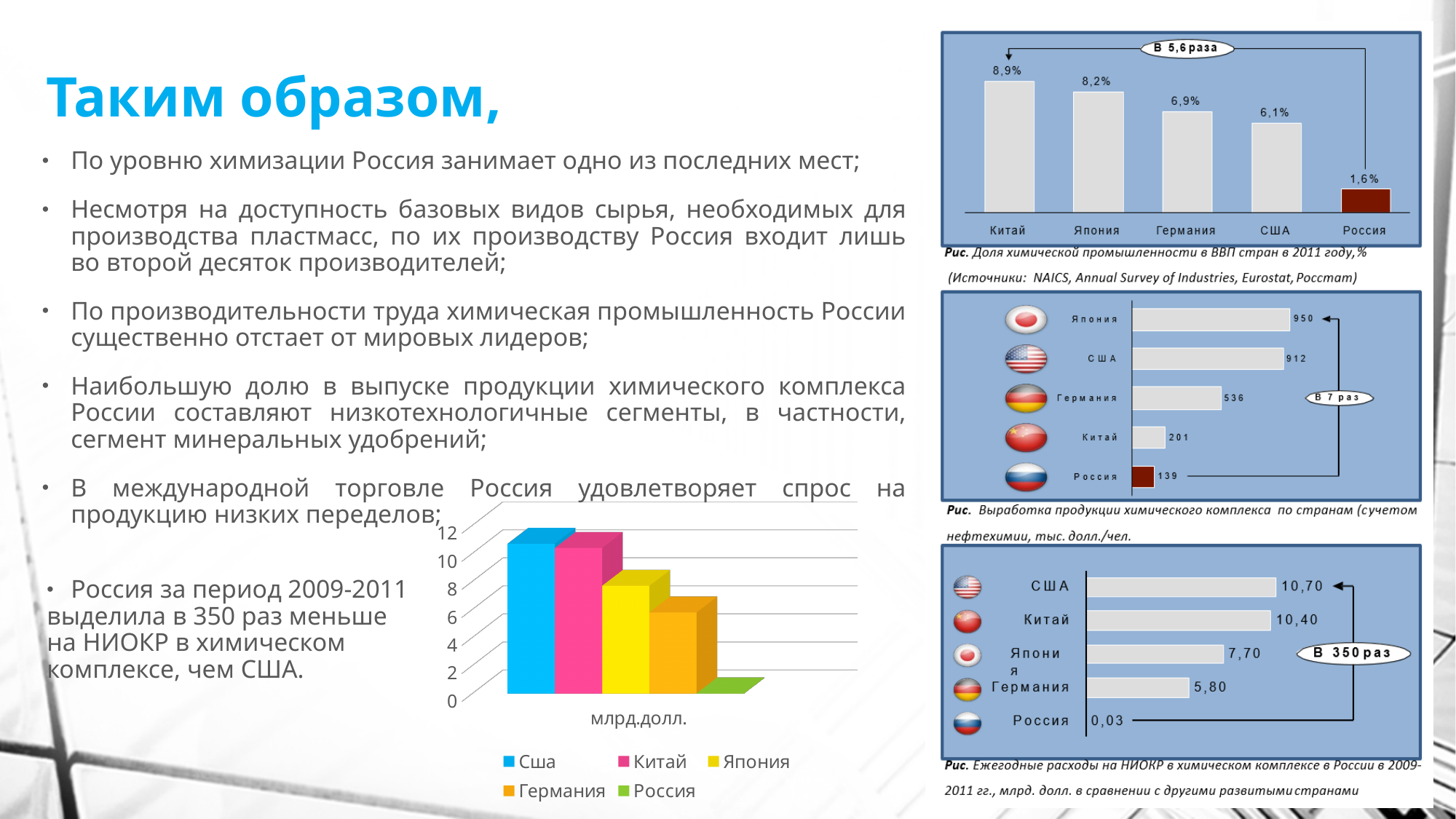
In the middle-right chart (output of chemical products per person), which is larger, Китай or Россия? Китай In the top-right chart (share of chemical industry in GDP, 2011), which country has the lowest value? Россия What kind of chart is the bottom-left chart with the legend США, Китай, Япония, Германия, Россия? bar chart In the top-right chart (share of chemical industry in GDP, 2011), what is the value for Китай? 8,9% In the bottom-right chart (annual R&D spending in the chemical complex), what is the difference between США and Китай? 0,30 How many countries are shown in the bottom-right chart (annual R&D spending in the chemical complex)? 5 In the bottom-right chart (annual R&D spending in the chemical complex), what is the value for Россия? 0,03 How many series does the legend of the bottom-left 3D chart list? 5 In the middle-right chart (output of chemical products per person), what is the value for Германия? 536 In the bottom-left 3D chart, is the value for Япония greater or less than 6? greater In the middle-right chart (output of chemical products per person), which country has the highest value? Япония In the top-right chart (share of chemical industry in GDP, 2011), what is the difference between Япония and США? 2,1%